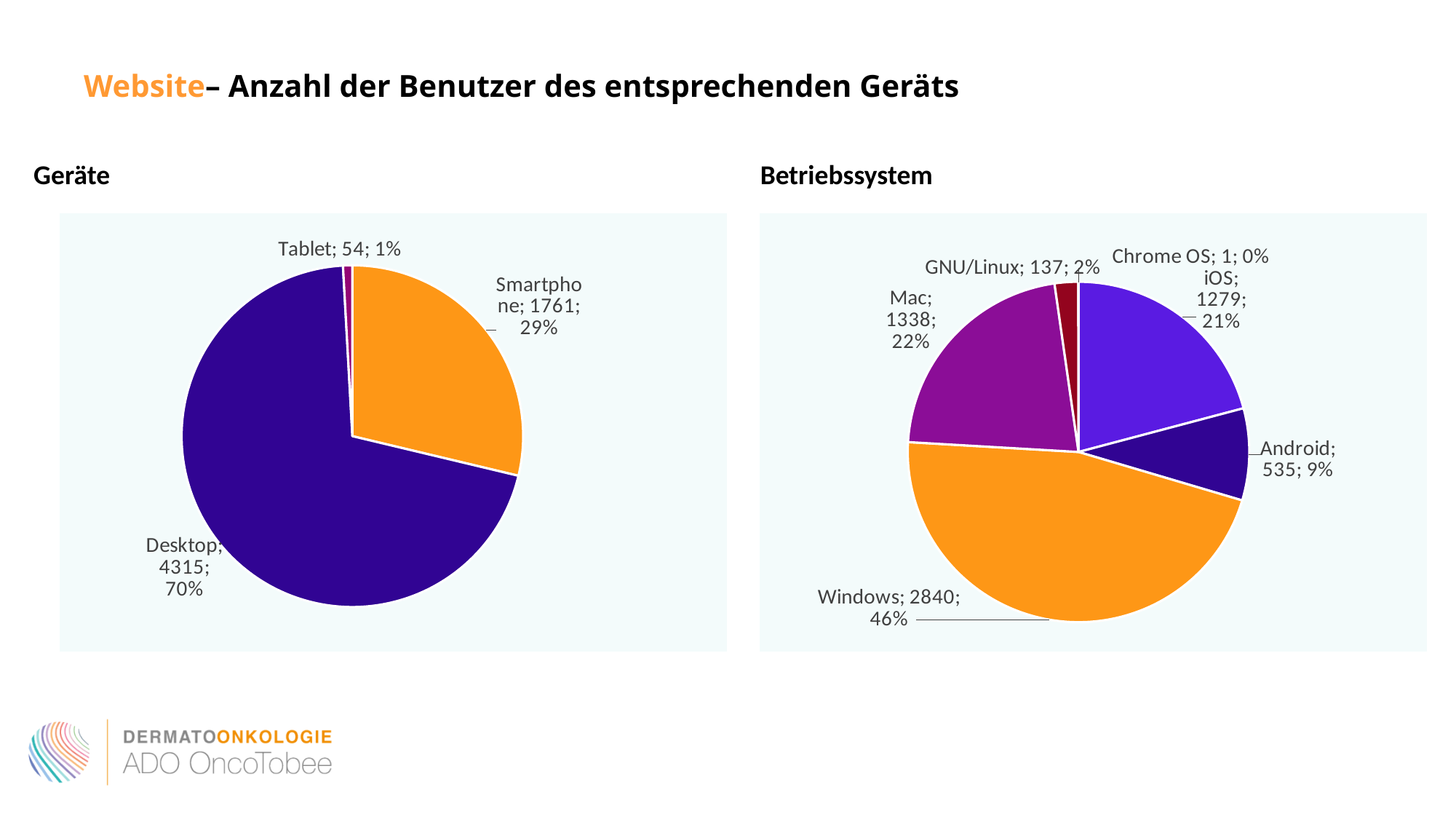
In the Geräte chart, how many categories are shown? 3 In the Betriebssystem chart, how many users are shown for Windows? 2840 In the Geräte chart, what is the difference in users between Desktop and Smartphone? 2554 In the Betriebssystem chart, which has more users, Mac or iOS? Mac In the Betriebssystem chart, how many categories are shown? 6 In the Betriebssystem chart, which operating system has the most users? Windows In the Betriebssystem chart, what is the difference in users between Android and GNU/Linux? 398 In the Betriebssystem chart, what share of the pie does Mac have? 22% In the Geräte chart, which category has the smallest number of users? Tablet In the Geräte chart, what share of the pie does Smartphone have? 29% What kind of chart is the Geräte chart? Pie chart In the Geräte chart, how many users are shown for Desktop? 4315